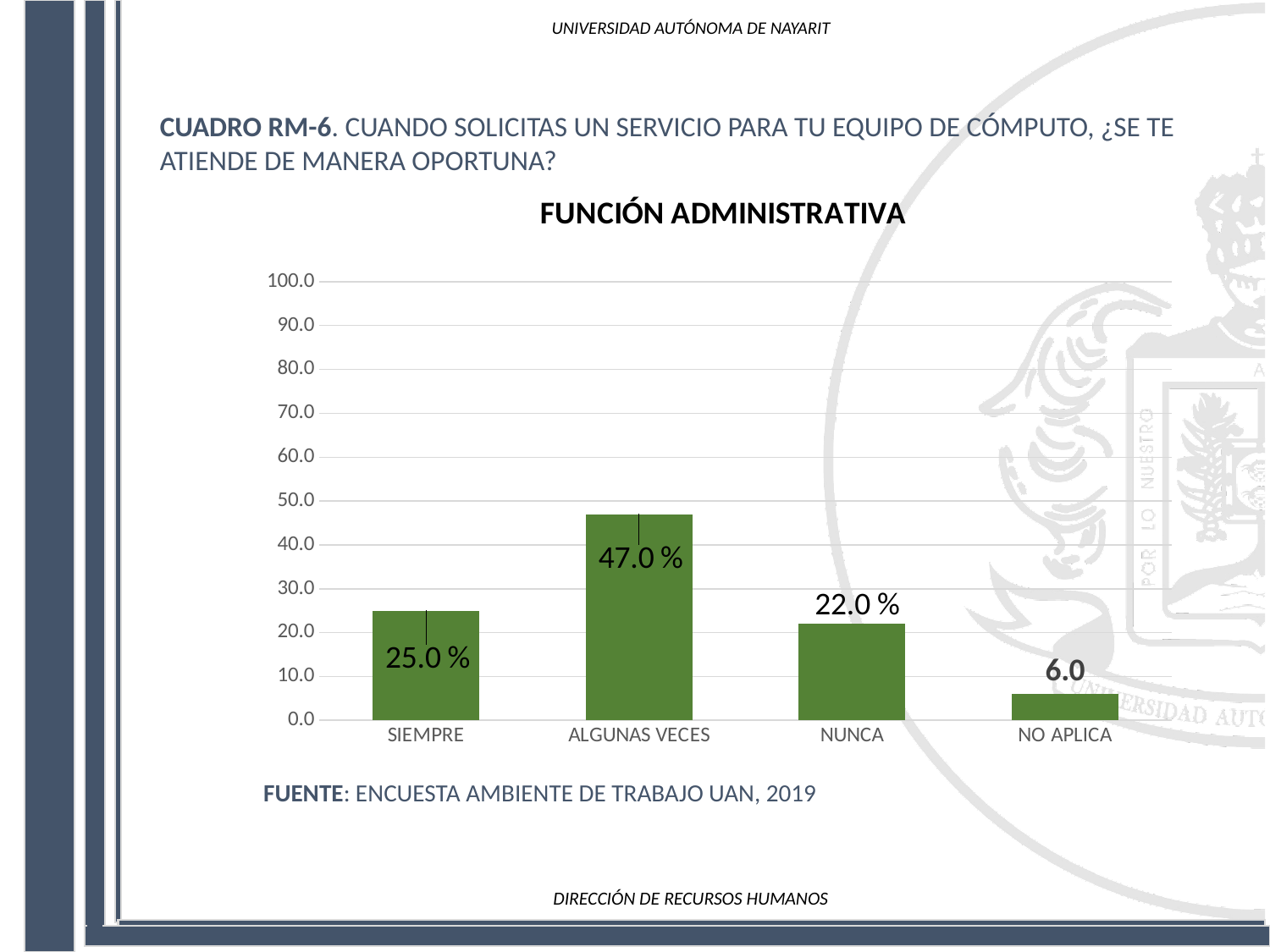
Which category has the lowest value? NO APLICA What is the difference between the values for ALGUNAS VECES and NUNCA? 25.0 % What is the difference between the values for ALGUNAS VECES and SIEMPRE? 22.0 % What is the value for NO APLICA? 6.0 What is the title of the chart? FUNCIÓN ADMINISTRATIVA Which category has the highest value? ALGUNAS VECES Which is larger, the value for SIEMPRE or the value for NUNCA? SIEMPRE What type of chart is shown on the slide? bar chart What is the value for NUNCA? 22.0 % How many categories are shown on the x axis? 4 What is the value for ALGUNAS VECES? 47.0 % What is the value for SIEMPRE? 25.0 %